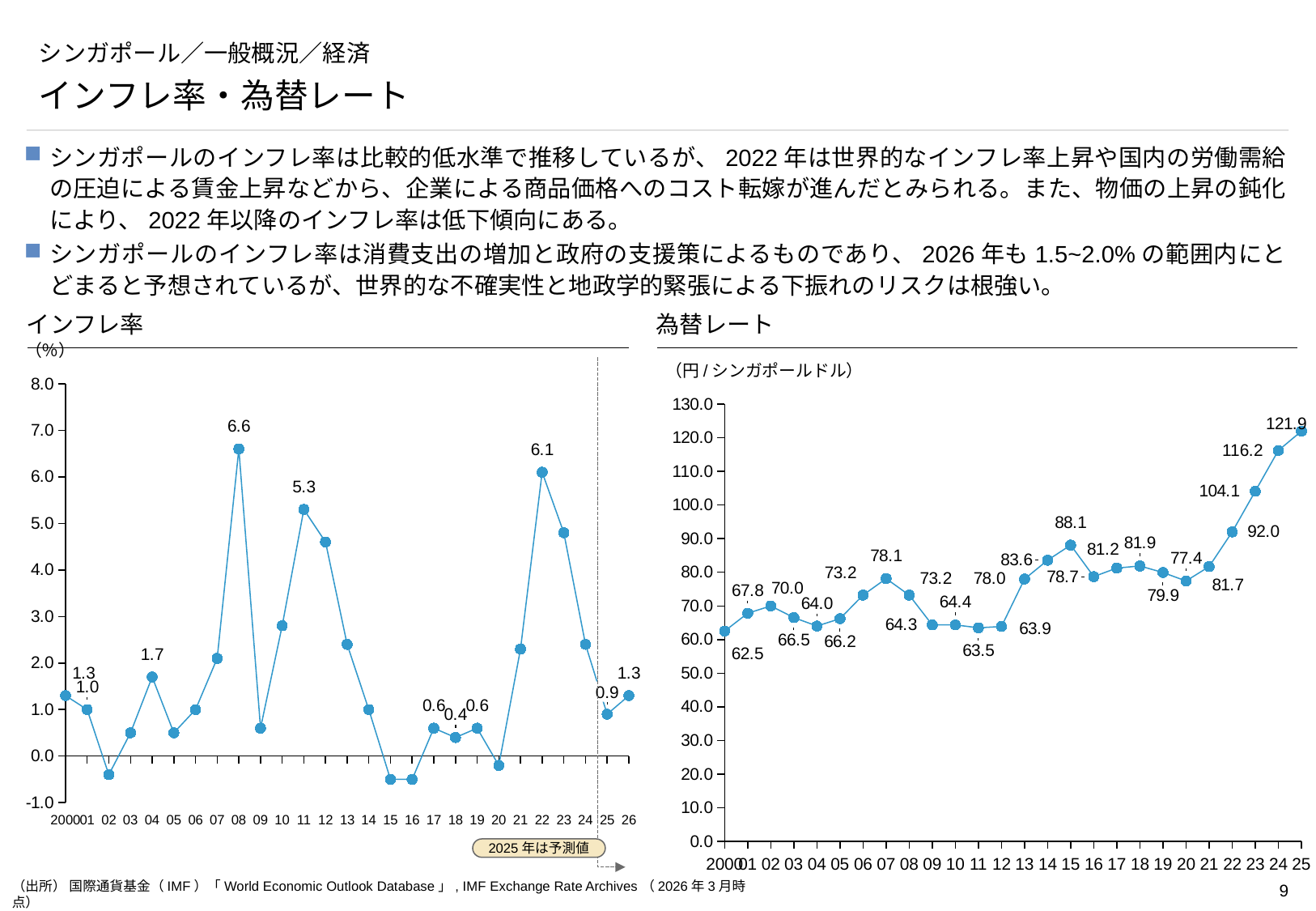
What unit is shown on the 為替レート chart? 円/シンガポールドル In the 為替レート chart, do the values rise or fall from 2021 to 2025? rise In the インフレ率 chart, is the value for 2015 greater or less than 0.0? less In the 為替レート chart, what is the value for 2025? 121.9 In the インフレ率 chart, what is the inflation rate for 2008? 6.6 In the 為替レート chart, which is larger, the value for 2007 or the value for 2015? 2015 In the インフレ率 chart, what is the value for 2022? 6.1 In the 為替レート chart, which year has the lowest value? 2000 In the インフレ率 chart, which year has the highest inflation rate? 2008 What kind of chart is the 為替レート chart? line chart In the 為替レート chart, what is the difference between the 2025 value and the 2024 value? 5.7 In the インフレ率 chart, what is the difference between the 2008 value and the 2022 value? 0.5